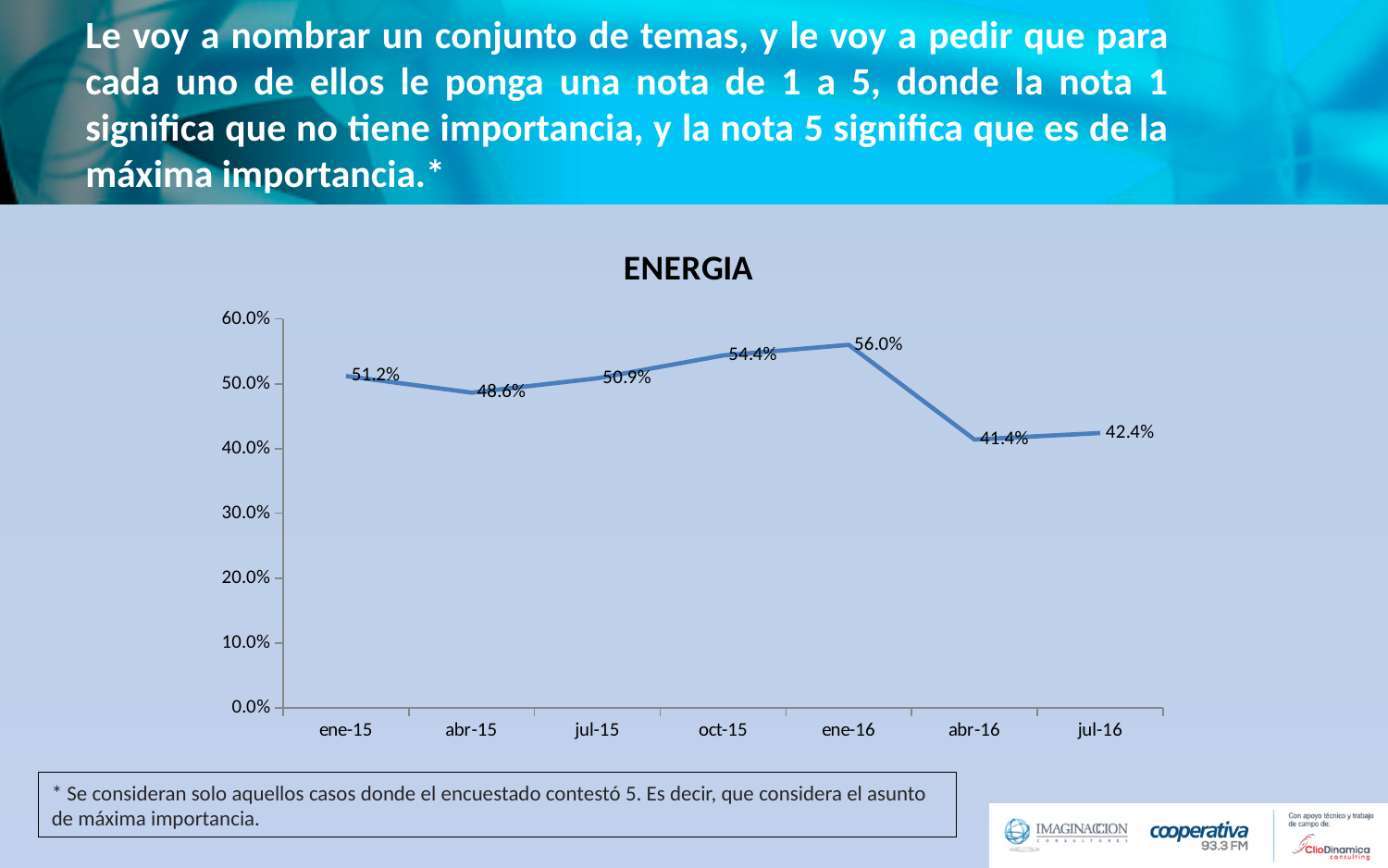
What is the value for abr-15 in the ENERGIA chart? 48.6% How many data points are plotted in the ENERGIA chart? 7 What is the title of the chart on the slide? ENERGIA Which is larger in the ENERGIA chart, the value for ene-15 or the value for jul-15? ene-15 What is the value for jul-16 in the ENERGIA chart? 42.4% Which period has the highest value in the ENERGIA chart? ene-16 Does the value in the ENERGIA chart rise or fall from ene-16 to abr-16? fall Which period has the lowest value in the ENERGIA chart? abr-16 What kind of chart is shown on the slide? line chart Is the value for oct-15 in the ENERGIA chart greater or less than 50.0%? greater What is the difference between the values for ene-16 and abr-16 in the ENERGIA chart? 14.6% What is the value for ene-16 in the ENERGIA chart? 56.0%